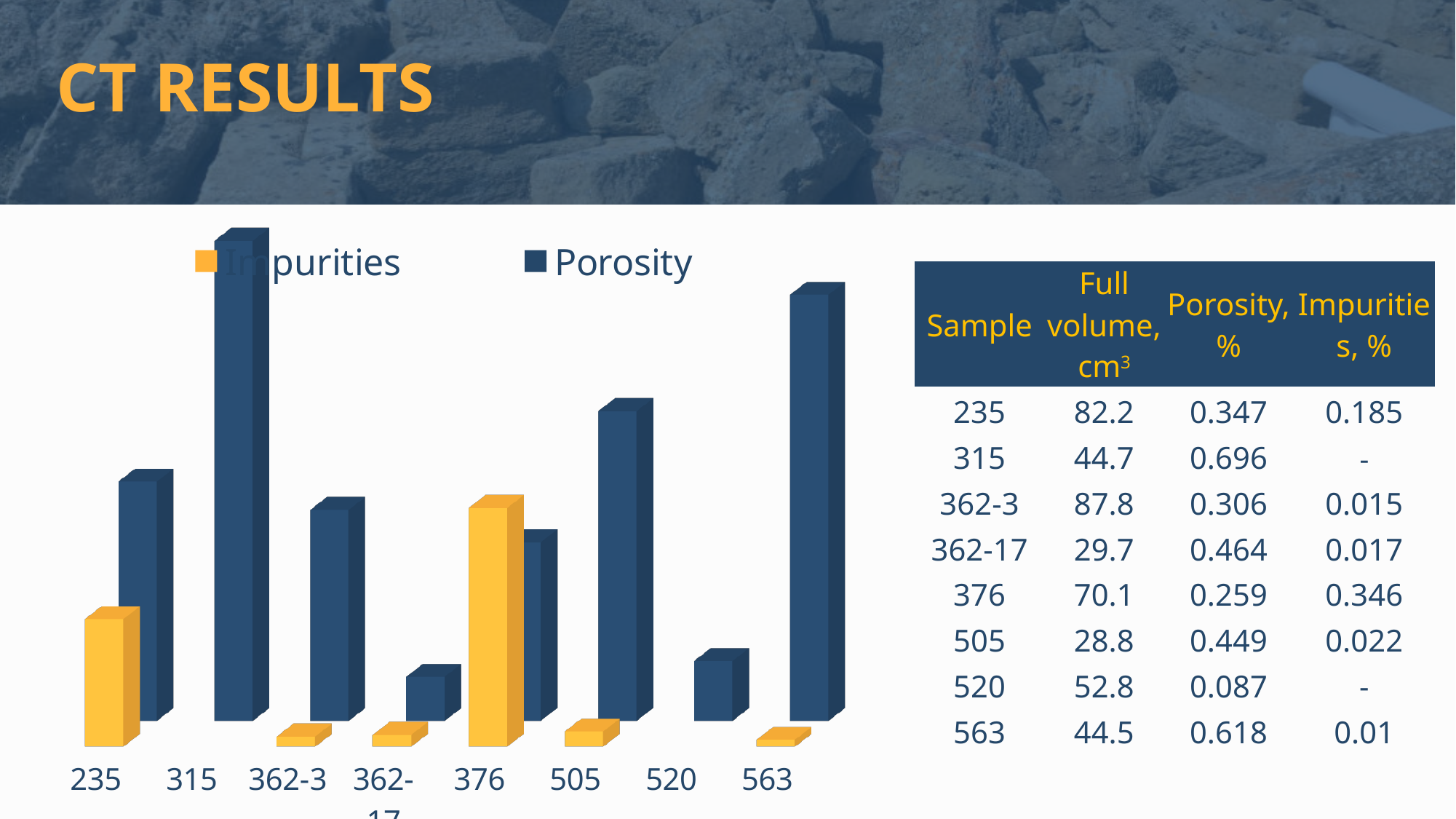
Which is larger, the Impurities bar for sample 235 or the Impurities bar for sample 362-3? 235 How many series does the chart legend list? 2 Which sample has the highest Impurities bar? 376 According to the table, what is the Impurities, % value for sample 376? 0.346 What colour are the Impurities bars in the chart? yellow Using the table values, what is the difference in Porosity, % between sample 315 and sample 520? 0.609 How many sample categories are shown along the x axis of the chart? 8 Is the Porosity bar for sample 563 taller or shorter than the Porosity bar for sample 505? taller Which sample has the highest Porosity bar? 315 What kind of chart is shown on the slide? bar chart According to the table, what is the Porosity, % value for sample 315? 0.696 Which sample has the lowest Porosity bar? 362-17